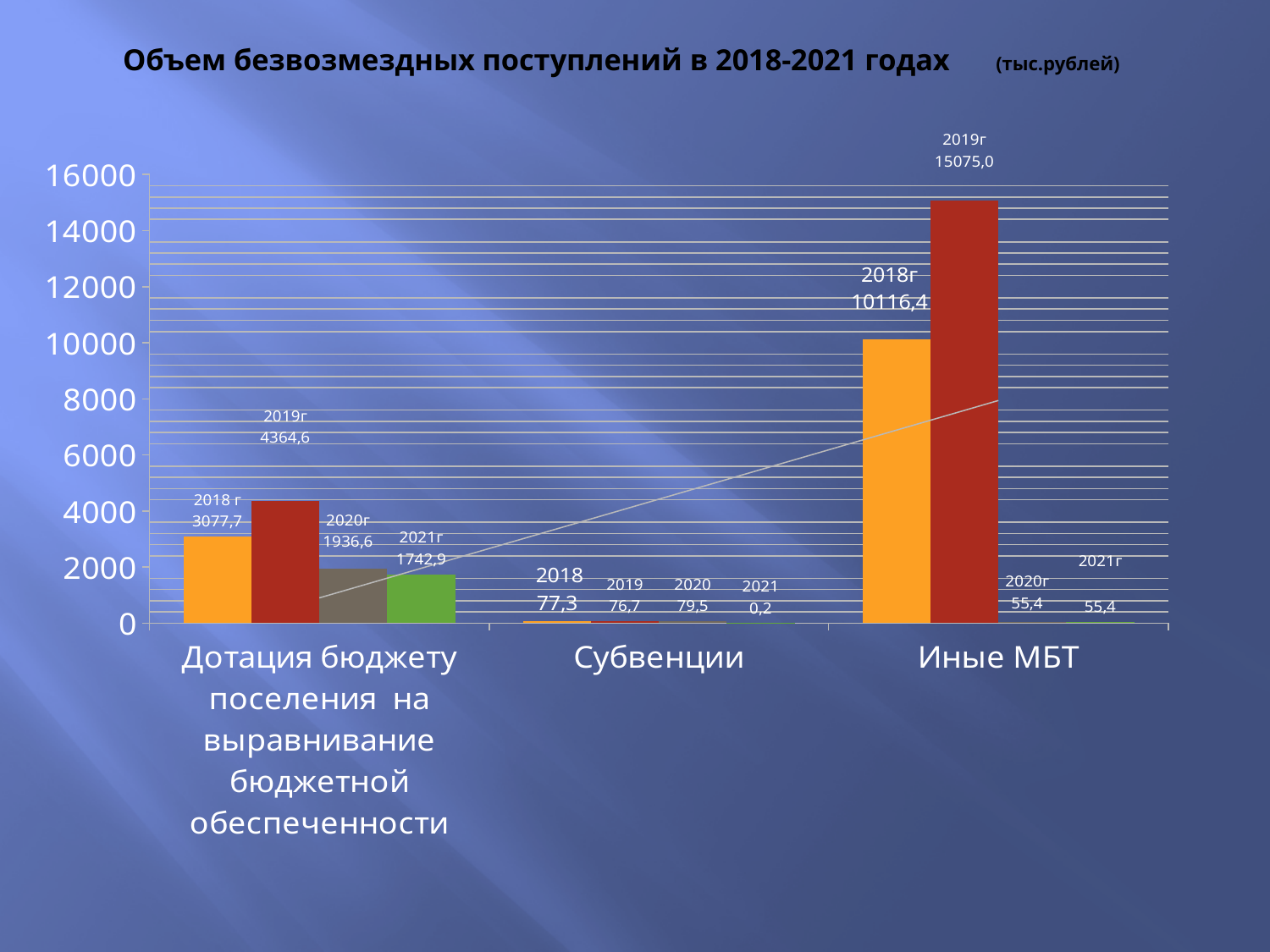
Which year has the highest value in the Дотация бюджету поселения на выравнивание бюджетной обеспеченности category? 2019 Which is larger: the 2018 value for Иные МБТ or the 2019 value for Дотация бюджету поселения на выравнивание бюджетной обеспеченности? 2018 value for Иные МБТ What is the value for 2018 in the Дотация бюджету поселения на выравнивание бюджетной обеспеченности category? 3077,7 What unit is given in the chart title? тыс.рублей How many categories are shown on the x axis? 3 What kind of chart is shown on the slide? Bar chart What is the value for 2020 in the Иные МБТ category? 55,4 What is the difference between the 2019 and 2018 values in the Иные МБТ category? 4958,6 Which year has the lowest value in the Субвенции category? 2021 What is the difference between the 2020 and 2021 values in the Дотация бюджету поселения на выравнивание бюджетной обеспеченности category? 193,7 What is the value for 2019 in the Иные МБТ category? 15075,0 What is the value for 2021 in the Субвенции category? 0,2